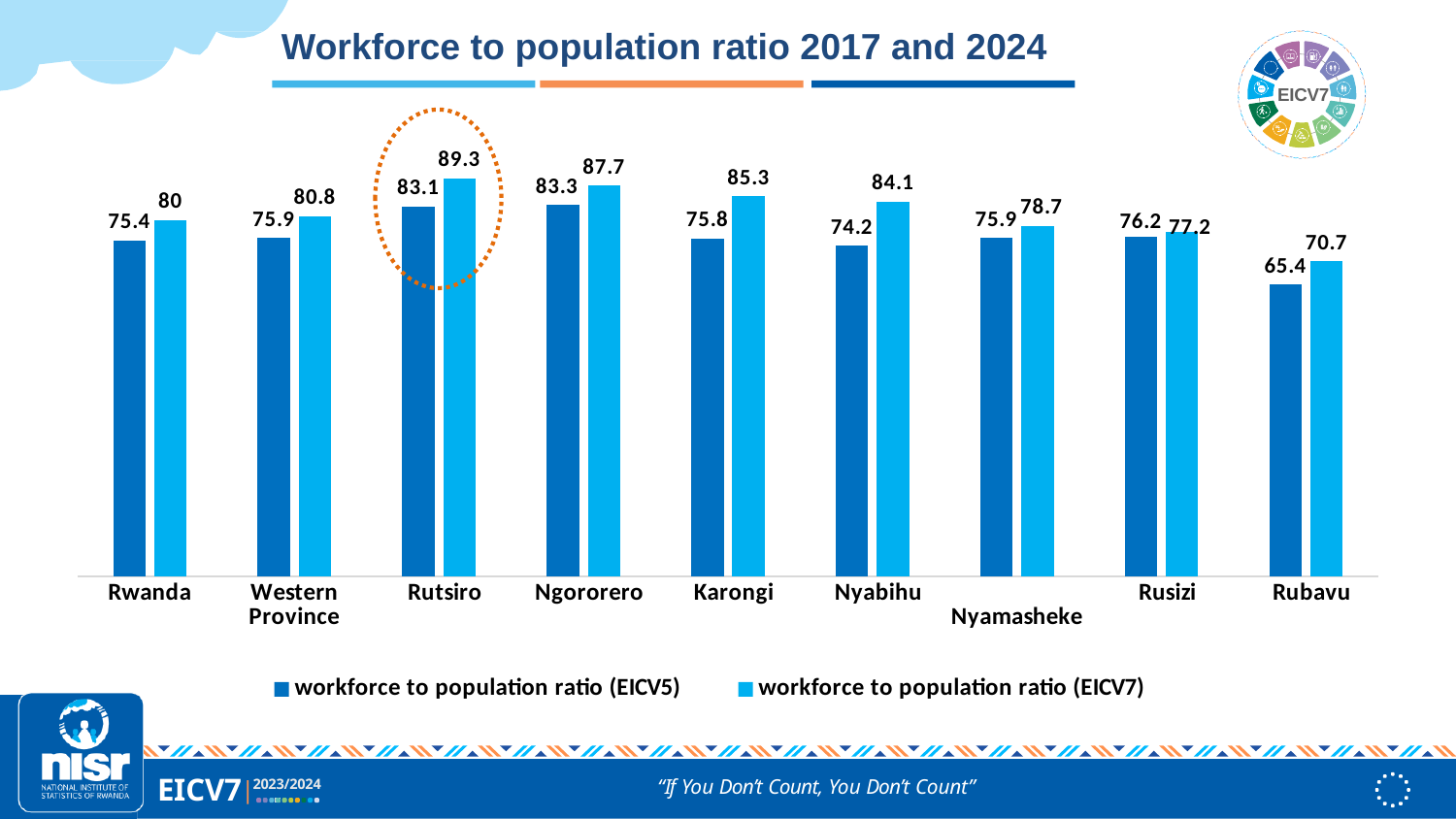
What is the workforce to population ratio (EICV7) for Rutsiro? 89.3 Which category has the lowest workforce to population ratio (EICV5)? Rubavu What is the workforce to population ratio (EICV5) for Rubavu? 65.4 What is the workforce to population ratio (EICV7) for Karongi? 85.3 What is the title of the chart? Workforce to population ratio 2017 and 2024 How many series does the legend list? 2 How many categories are shown on the x axis of the chart? 9 Which category on the chart is highlighted with a dotted orange circle? Rutsiro What is the difference between the EICV7 and EICV5 workforce to population ratio for Nyabihu? 9.9 Which is larger, the EICV5 workforce to population ratio for Ngororero or for Rutsiro? Ngororero Which category has the highest workforce to population ratio (EICV7)? Rutsiro What kind of chart is shown on the slide? Bar chart